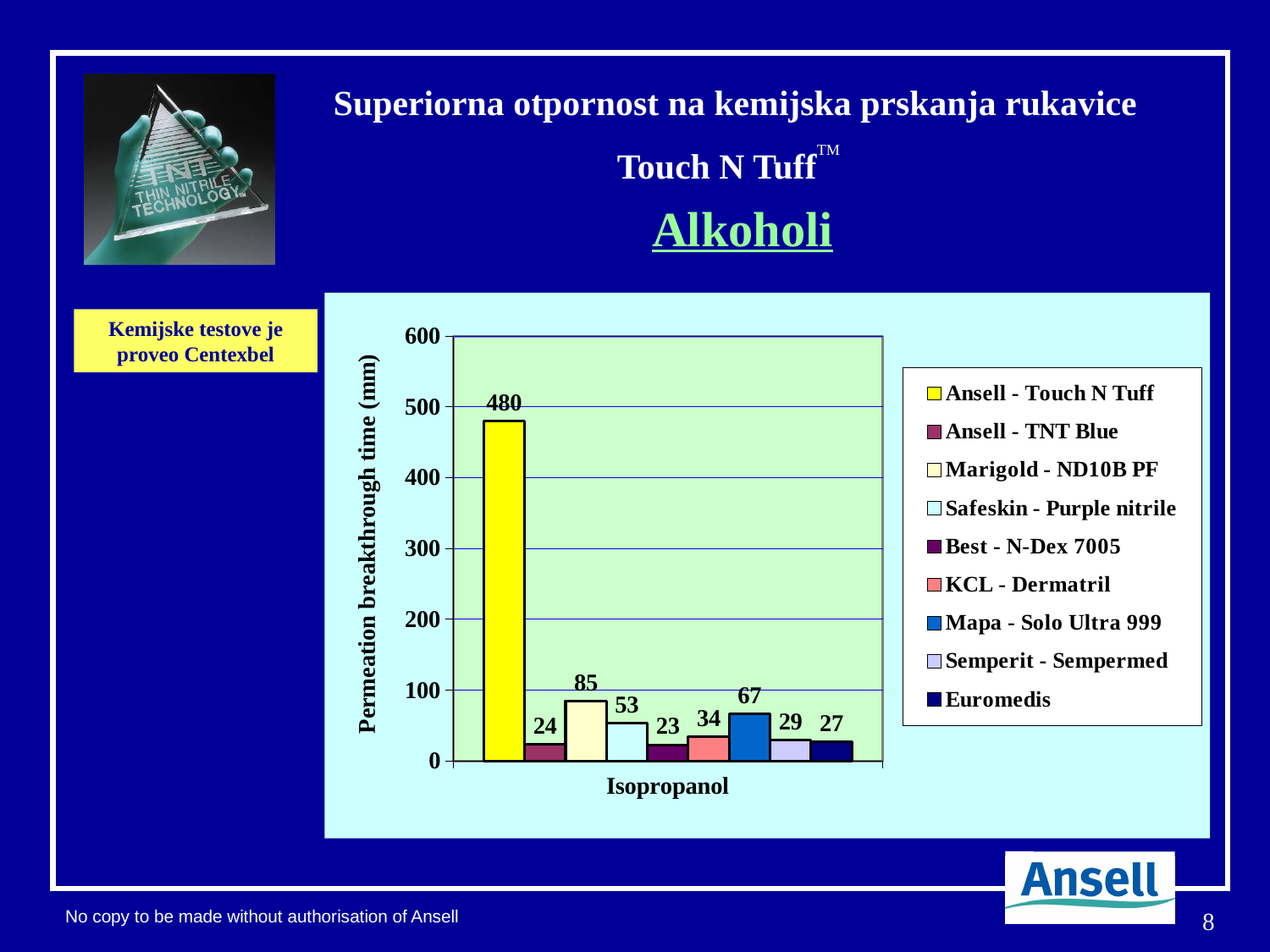
What is the label on the x axis of the chart? Isopropanol Which series has the highest permeation breakthrough time? Ansell - Touch N Tuff What is the permeation breakthrough time for Ansell - Touch N Tuff on Isopropanol? 480 Which is larger, the value for Safeskin - Purple nitrile or the value for KCL - Dermatril? Safeskin - Purple nitrile What is the y-axis title of the chart? Permeation breakthrough time (mm) What kind of chart is shown on the slide? Bar chart What is the value for Best - N-Dex 7005? 23 What is the value for Marigold - ND10B PF? 85 Which series has the lowest permeation breakthrough time? Best - N-Dex 7005 What is the difference between the values for Ansell - Touch N Tuff and Marigold - ND10B PF? 395 How many series does the legend list? 9 What is the value for Mapa - Solo Ultra 999? 67